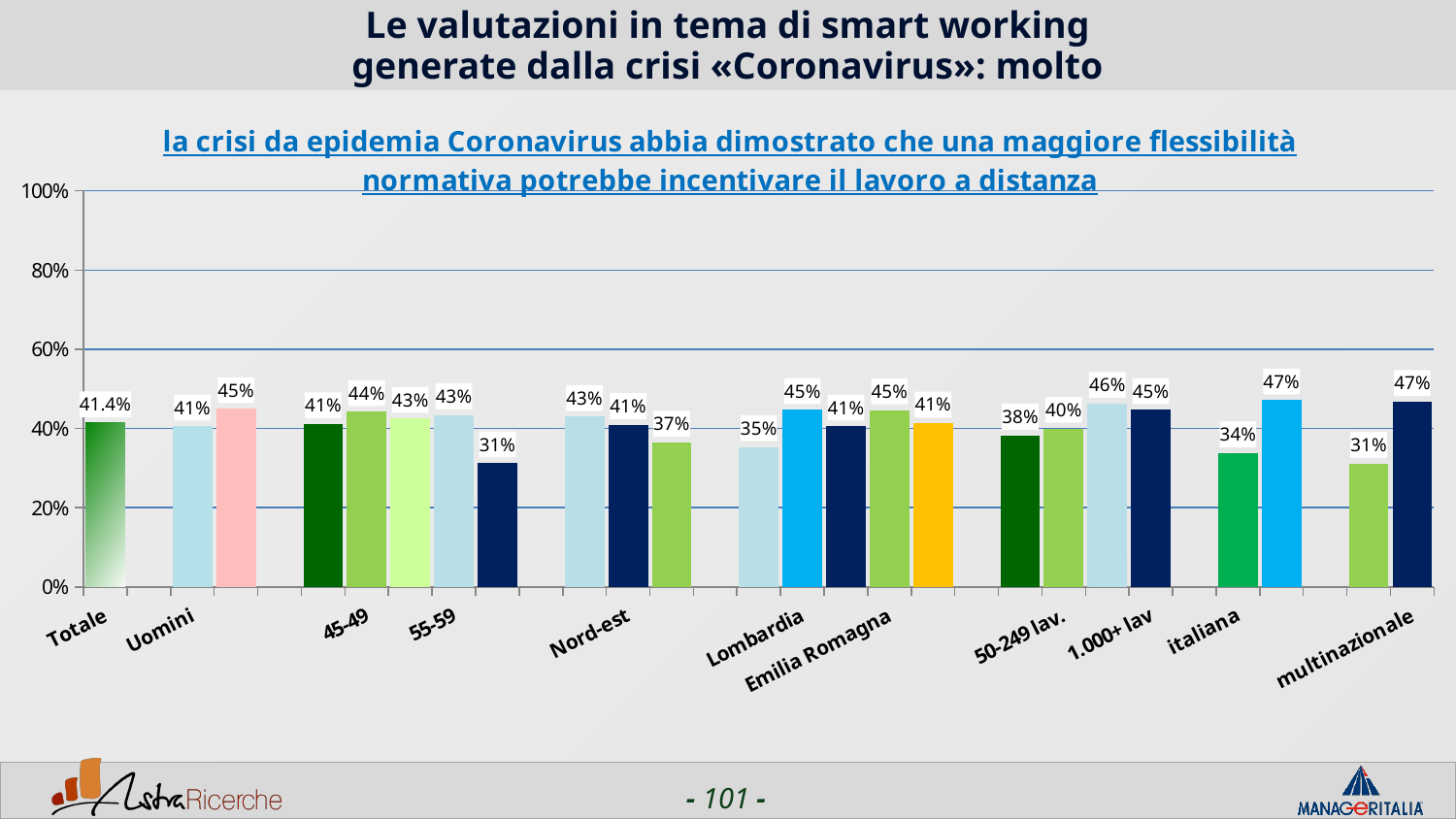
What is the value for italiana? 34% What is the value for 45-49? 44% What is the difference between the values for multinazionale and italiana? 13% How many bars are plotted in the chart? 24 Is the value for italiana greater or less than 40%? less What is the value for Uomini? 41% What is the value for Totale? 41.4% What is the value for Lombardia? 45% What is the difference between the values for 45-49 and 55-59? 1% What is the value for multinazionale? 47% Which is larger, the value for 1.000+ lav or the value for 50-249 lav.? 1.000+ lav What kind of chart is shown on the slide? bar chart